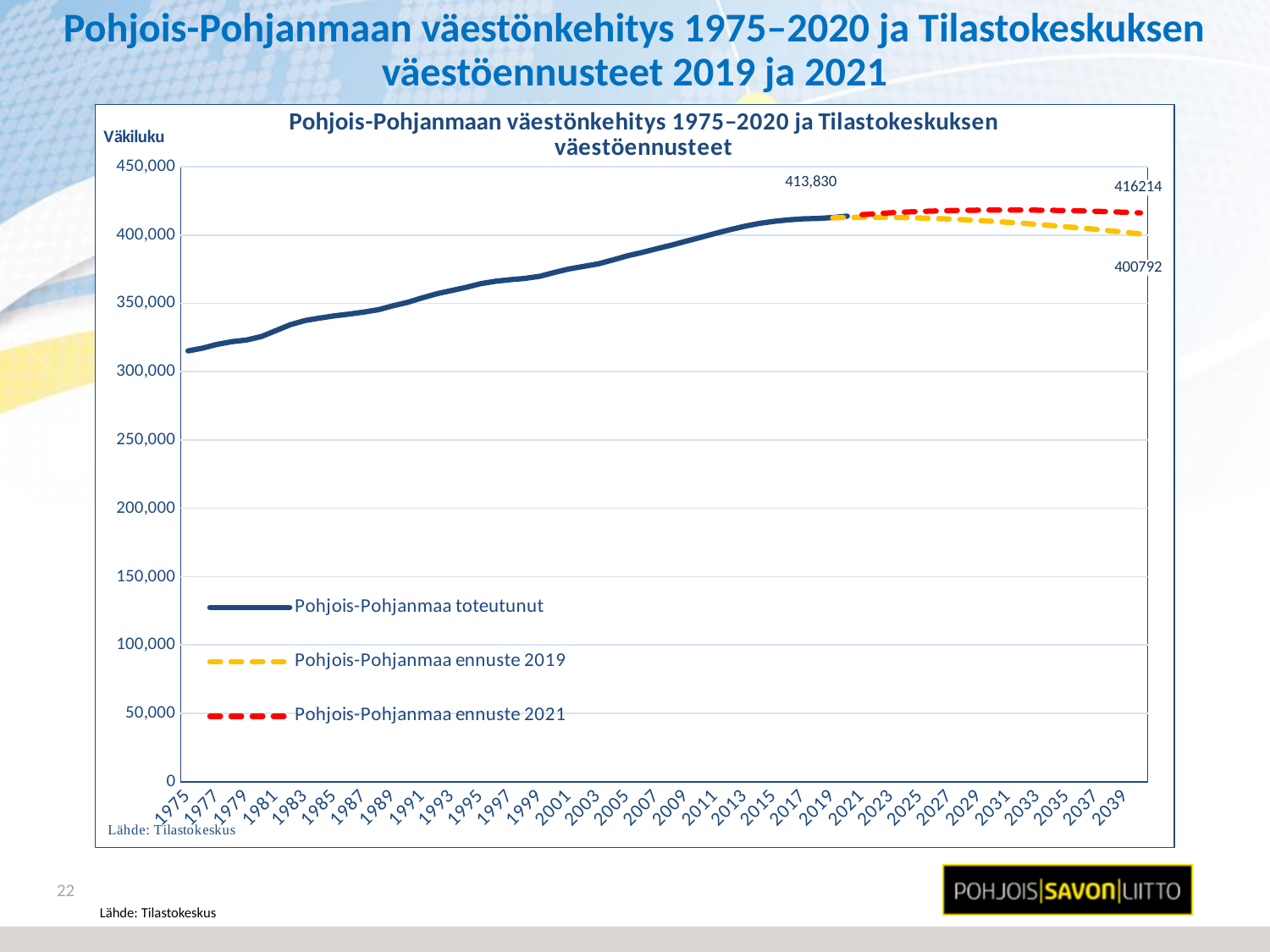
What value is labelled at the end of the Pohjois-Pohjanmaa toteutunut line? 413,830 What value is labelled at the end of the Pohjois-Pohjanmaa ennuste 2021 line? 416214 Does the Pohjois-Pohjanmaa toteutunut line rise or fall from 1975 to 2020? rises Is the value of the Pohjois-Pohjanmaa toteutunut line in 1975 greater or less than 350,000? less Which forecast line ends at a higher value, ennuste 2019 or ennuste 2021? Pohjois-Pohjanmaa ennuste 2021 What colour is the Pohjois-Pohjanmaa ennuste 2021 line? red Is the value of the Pohjois-Pohjanmaa toteutunut line in 2001 greater or less than 350,000? greater How many series does the legend list? 3 What is the difference between the labelled end values of the ennuste 2021 and ennuste 2019 lines? 15422 What label is shown on the vertical axis of the chart? Väkiluku What value is labelled at the end of the Pohjois-Pohjanmaa ennuste 2019 line? 400792 What kind of chart is shown on the slide? line chart